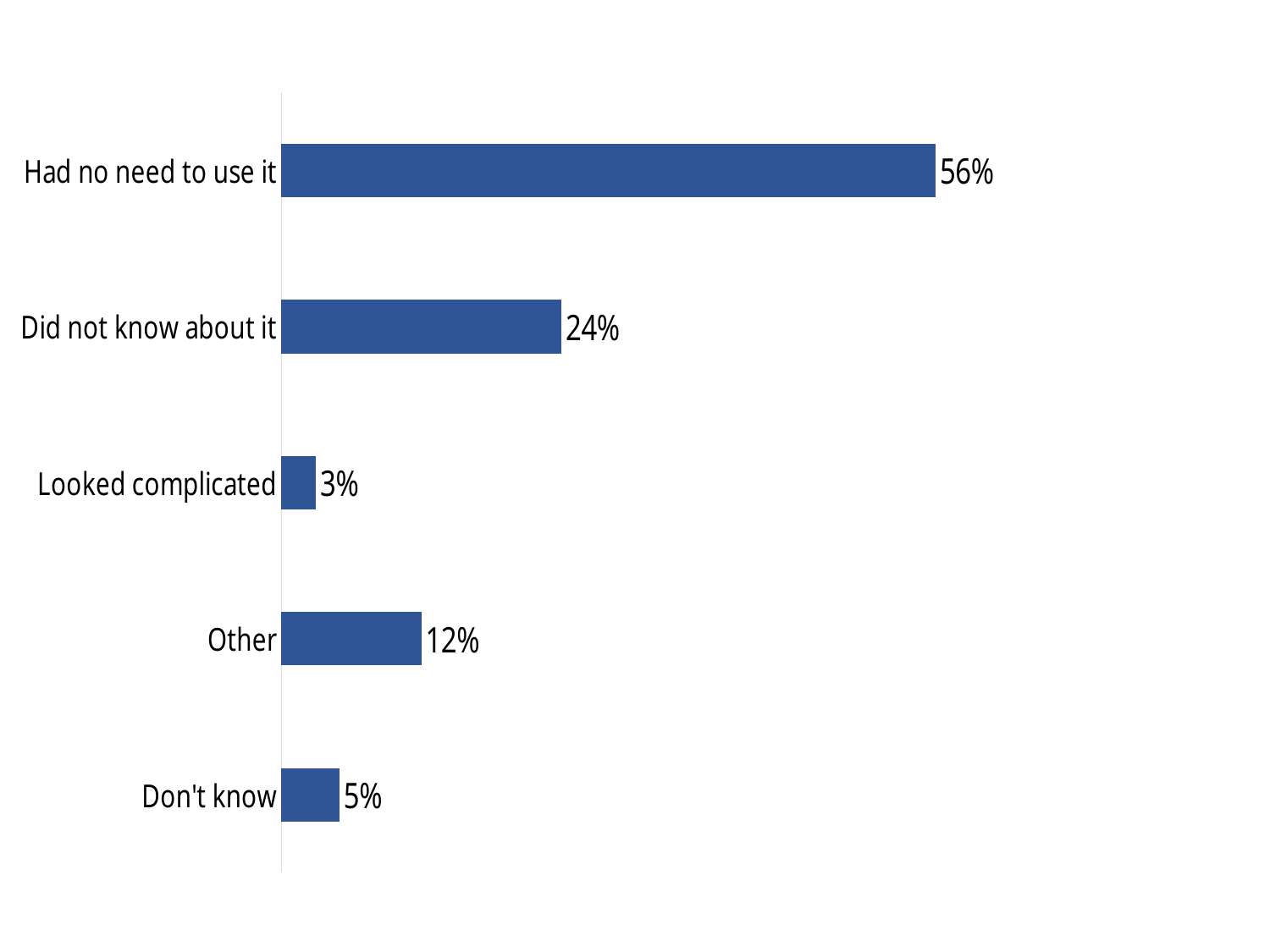
What is the value for "Looked complicated"? 3% What kind of chart is shown on the slide? Bar chart Which category has the lowest value? Looked complicated What is the value for "Don't know"? 5% What is the difference between the values for "Had no need to use it" and "Did not know about it"? 32% How many categories are shown in the chart? 5 Which category has the highest value? Had no need to use it What is the value for "Other"? 12% What is the value for "Had no need to use it"? 56% What is the difference between the values for "Other" and "Don't know"? 7% What is the value for "Did not know about it"? 24% Which is larger, the value for "Other" or the value for "Don't know"? Other